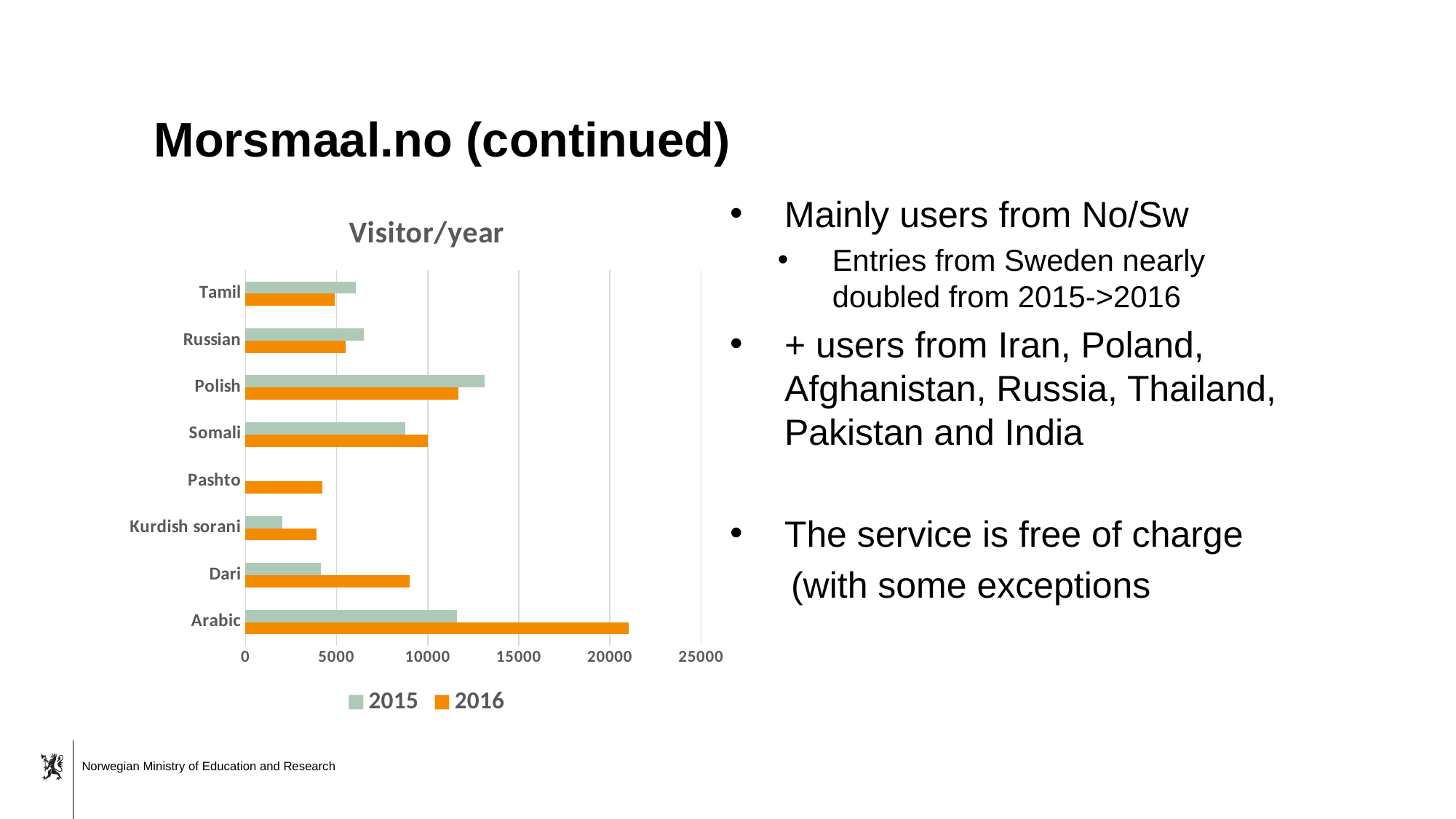
What kind of chart is shown on the slide? bar chart Is the 2015 value for Kurdish sorani greater or less than 5000? less Is the 2016 value for Dari greater or less than 10000? less Which language has the highest value for 2016? Arabic For Arabic, which year has the larger value, 2015 or 2016? 2016 How many series does the chart's legend list? 2 Is the 2016 value for Arabic greater or less than 20000? greater What is the title of the chart? Visitor/year For Polish, which year has the larger value, 2015 or 2016? 2015 Which language has the highest value for 2015? Polish How many language categories are shown on the chart? 8